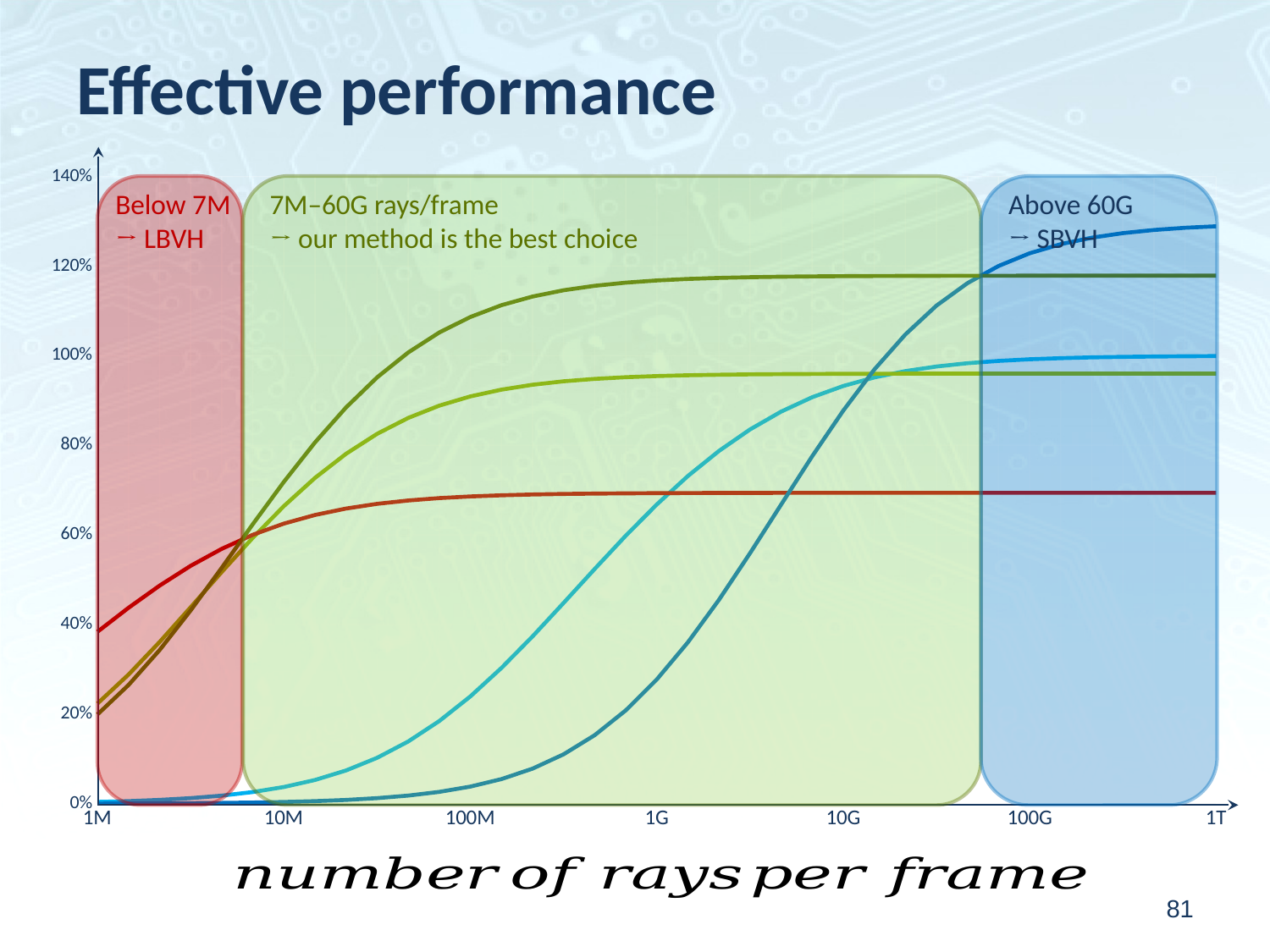
Is the value of the dark green curve at 1T greater or less than 100%? greater What is the label of the x axis? number of rays per frame Is the value of the red curve at 1T greater or less than 60%? greater Is the value of the dark blue curve at 1M greater or less than 20%? less At 1T rays per frame, which curve is higher, the red curve or the dark blue curve? dark blue curve Does the dark blue curve rise or fall as the number of rays per frame increases? rise How many tick labels are shown on the x axis? 7 How many curves are plotted on the chart? 5 What is the title of the slide's chart? Effective performance What kind of chart is shown on the slide? line chart